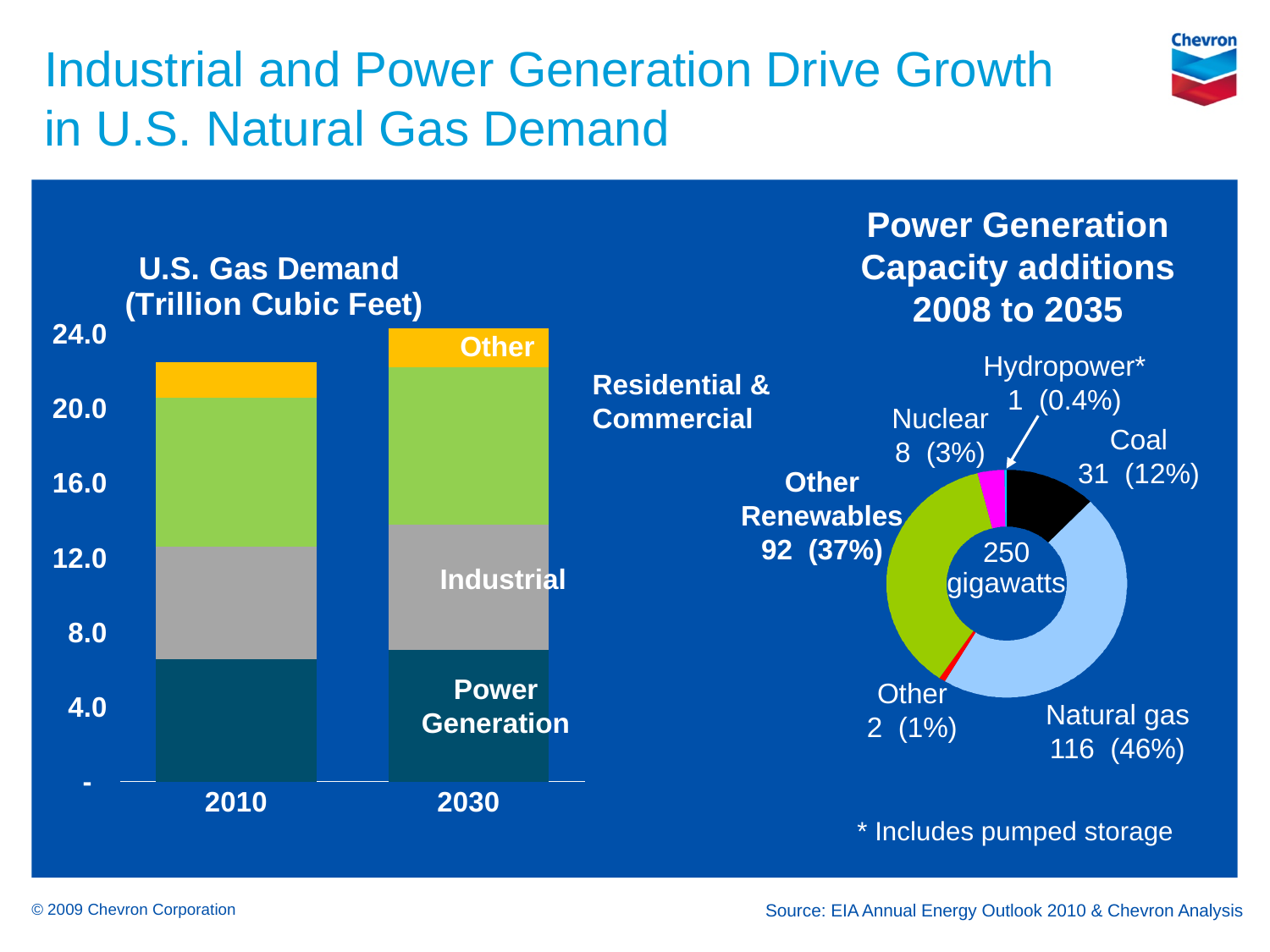
In the U.S. Gas Demand chart, which year has the higher total gas demand, 2010 or 2030? 2030 In the U.S. Gas Demand chart, is the total demand for 2010 greater or less than 20.0? greater In the U.S. Gas Demand chart, is the Power Generation segment for 2010 greater or less than 8.0? less In the Power Generation Capacity additions chart, what total is shown in the centre of the donut? 250 gigawatts In the U.S. Gas Demand chart, how many years are shown on the x axis? 2 In the Power Generation Capacity additions chart, what share of capacity additions is Other Renewables? 37% In the U.S. Gas Demand chart, does total gas demand rise or fall from 2010 to 2030? rise In the U.S. Gas Demand chart, how many segments make up each stacked bar? 4 In the Power Generation Capacity additions chart, what is the value for Natural gas? 116 (46%) In the Power Generation Capacity additions chart, which category has the smallest capacity addition? Hydropower* In the Power Generation Capacity additions chart, what is the difference in gigawatts between Natural gas and Other Renewables? 24 In the U.S. Gas Demand chart, what kind of chart is shown? stacked bar chart